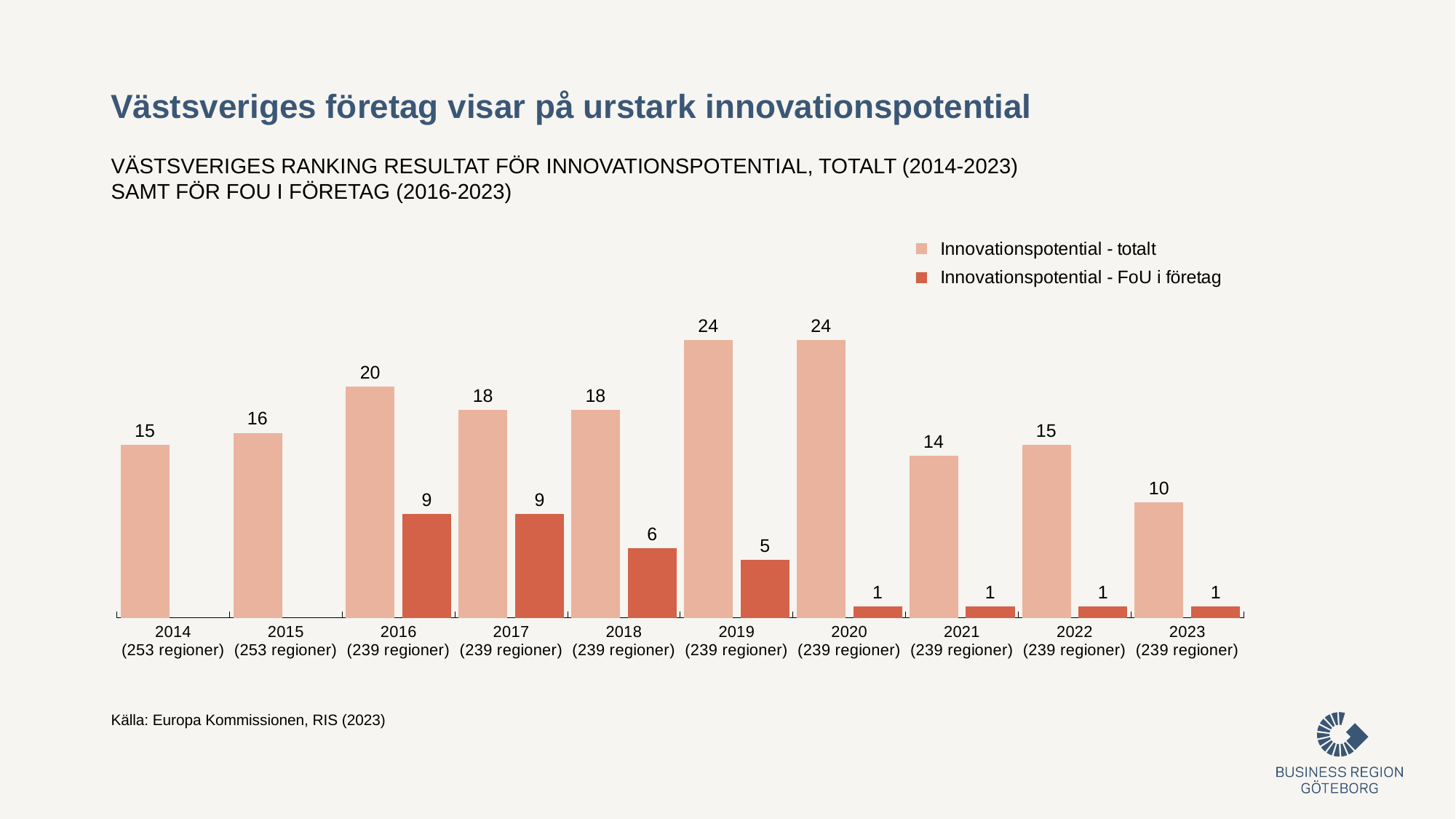
Which year has the lowest value for Innovationspotential - totalt? 2023 How many years are shown on the x axis? 10 What is the source cited below the chart? Källa: Europa Kommissionen, RIS (2023) Does Innovationspotential - FoU i företag rise or fall from 2016 to 2023? Fall What is the difference between Innovationspotential - totalt in 2019 and in 2021? 10 What is the value for Innovationspotential - FoU i företag in 2018? 6 What kind of chart is shown on the slide? Bar chart Which is larger: Innovationspotential - totalt in 2015 or in 2022? 2015 What is the value for Innovationspotential - totalt in 2023? 10 How many series does the legend list? 2 Which year has the highest value for Innovationspotential - FoU i företag? 2016 and 2017 What is the value for Innovationspotential - totalt in 2016? 20